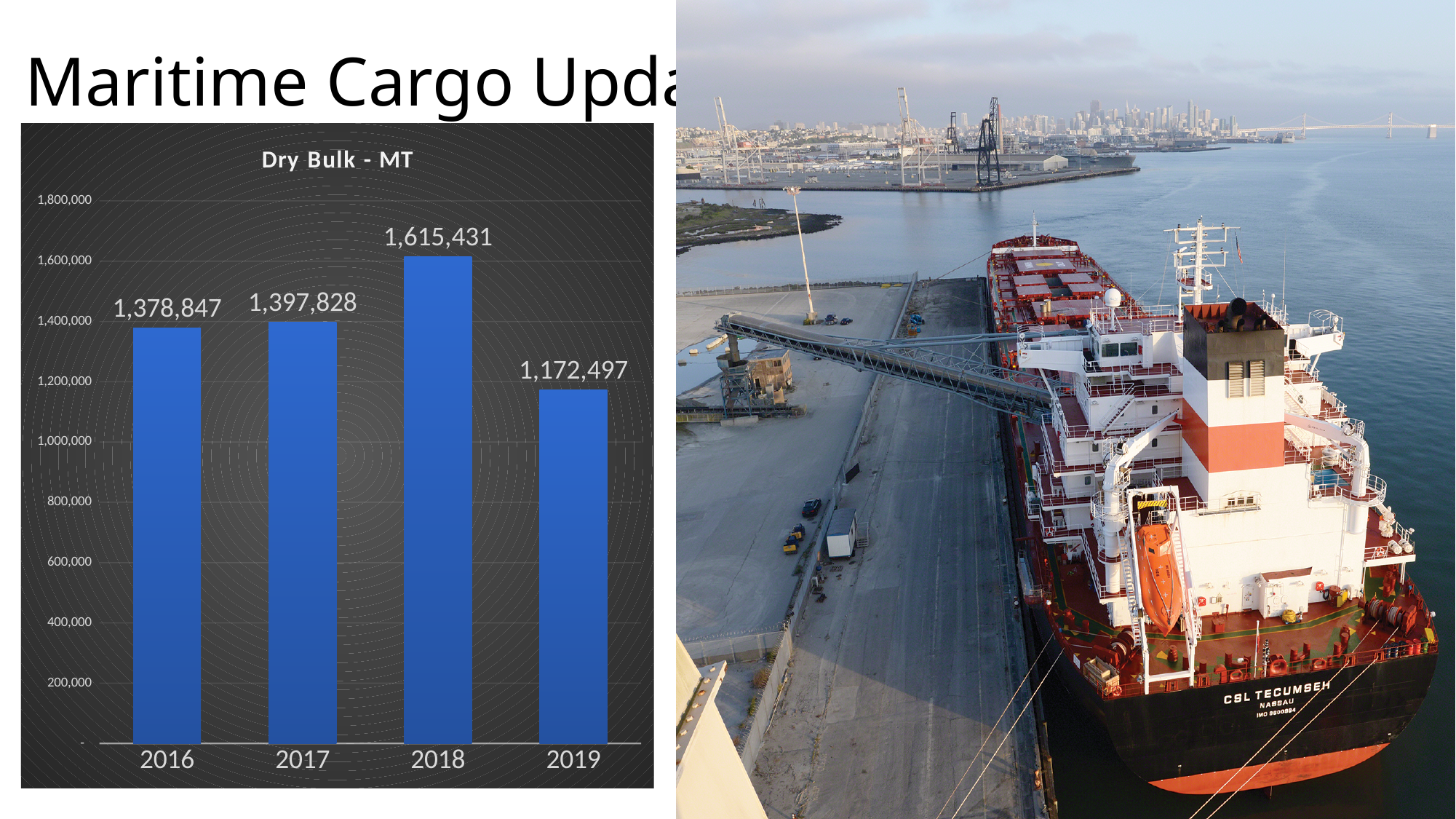
What is the Dry Bulk value for 2018? 1,615,431 Is the Dry Bulk value for 2019 greater or less than 1,200,000? less Which year has the lowest Dry Bulk value? 2019 What kind of chart is shown on the slide? bar chart Which year has a larger Dry Bulk value, 2016 or 2018? 2018 What is the difference between the Dry Bulk values for 2017 and 2016? 18,981 Which year has the highest Dry Bulk value? 2018 What is the Dry Bulk value for 2016? 1,378,847 What is the title of the chart? Dry Bulk - MT What is the difference between the Dry Bulk values for 2018 and 2019? 442,934 What is the Dry Bulk value for 2019? 1,172,497 How many years are shown on the chart? 4